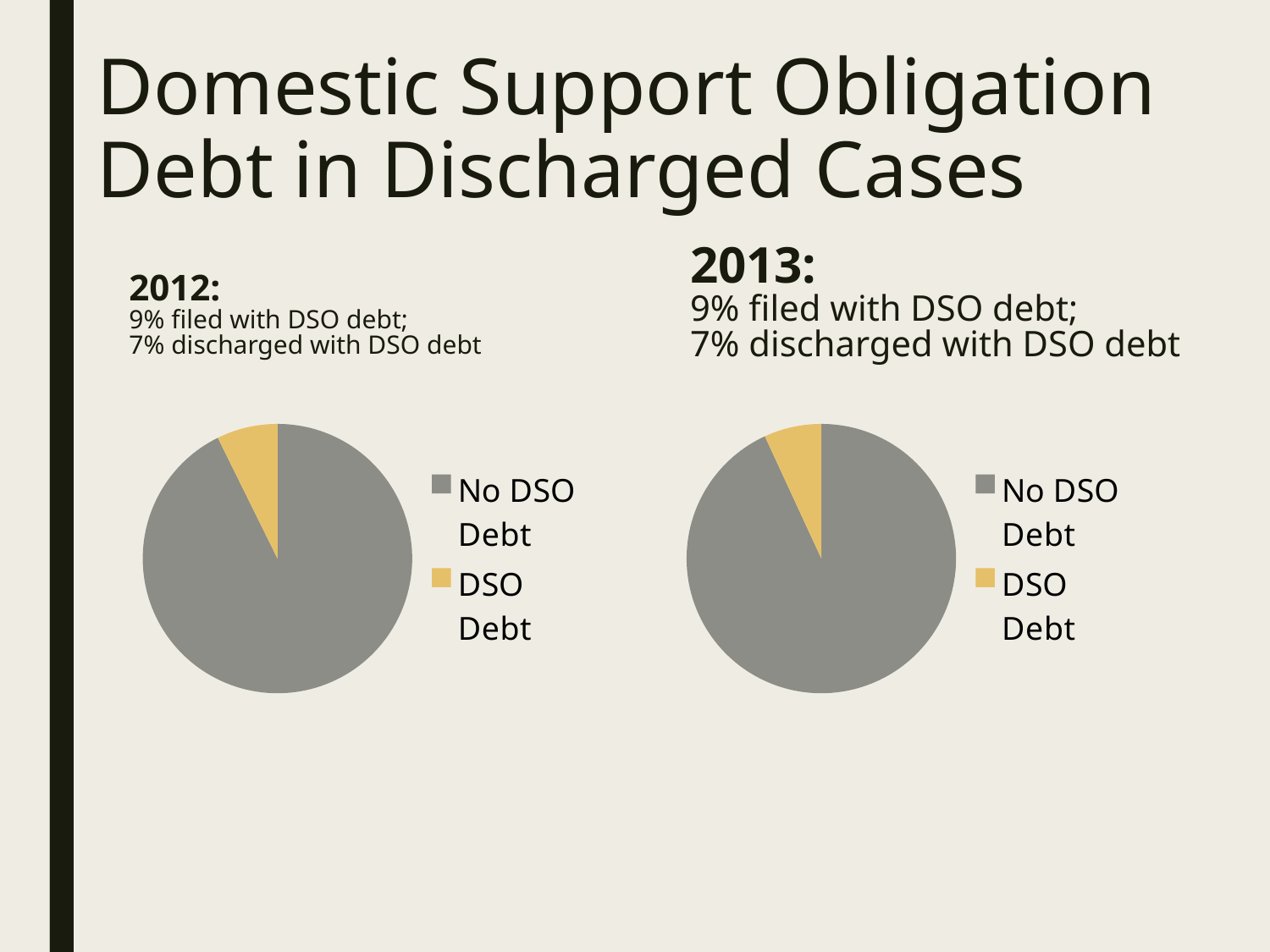
In the left chart (2012), how many slices does the pie have? 2 In the right chart (2013), which slice is the largest? No DSO Debt In the left chart (2012), which slice is the largest? No DSO Debt How many pie charts are shown on the slide? 2 What kind of chart is the right chart (2013)? pie chart In the right chart (2013), which slice is the smallest? DSO Debt In the right chart (2013), what colour is the No DSO Debt slice? grey In the left chart (2012), what colour is the DSO Debt slice? yellow What kind of chart is the left chart (2012)? pie chart In the right chart (2013), which is larger, the No DSO Debt slice or the DSO Debt slice? No DSO Debt In the right chart (2013), how many entries does the legend list? 2 In the left chart (2012), which slice is the smallest? DSO Debt